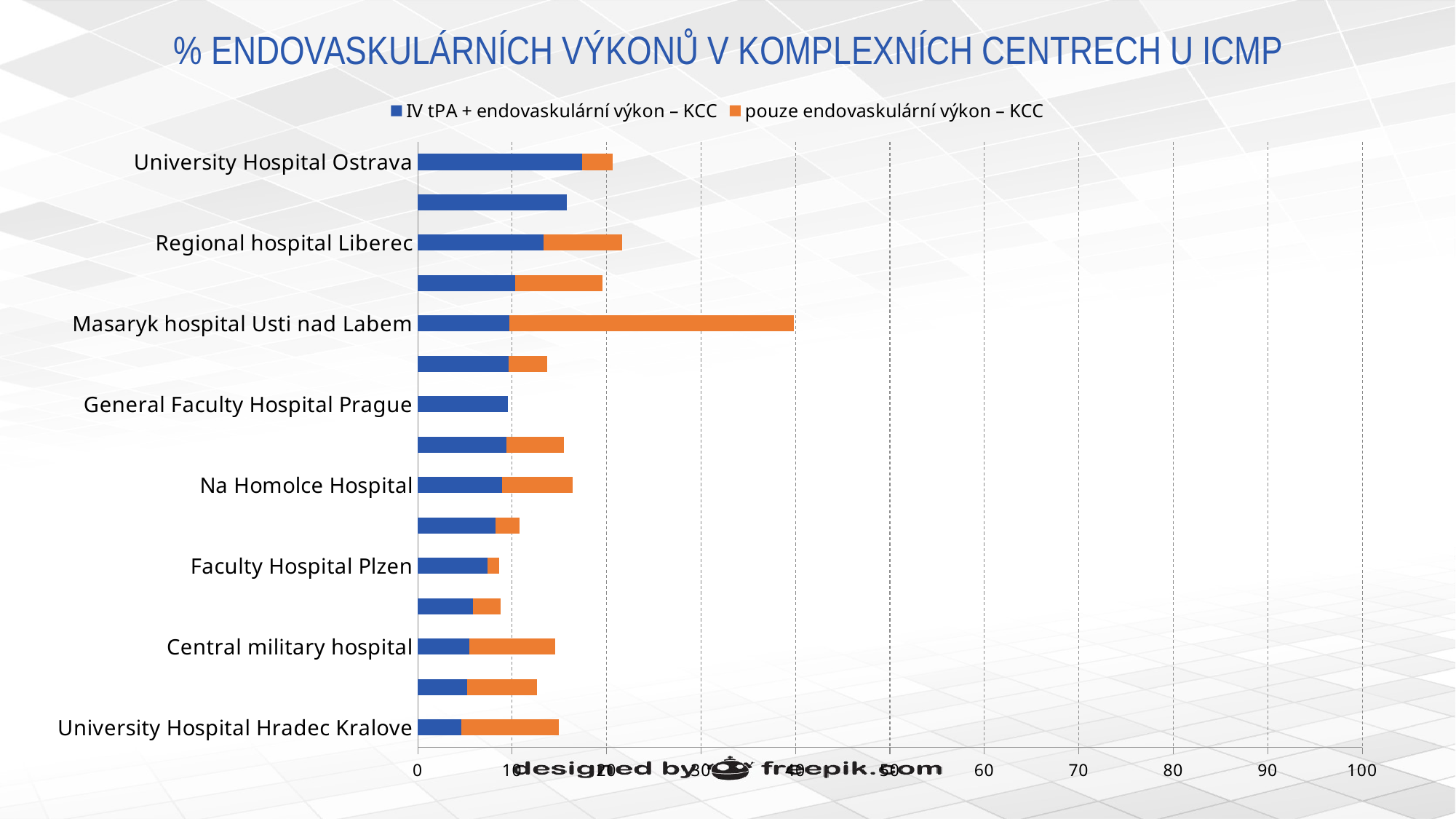
What are the two series named in the legend? IV tPA + endovaskulární výkon – KCC; pouze endovaskulární výkon – KCC What kind of chart is shown on the slide? bar chart Is the total bar for Masaryk hospital Usti nad Labem greater or less than 30? greater How many bars are plotted in the chart? 15 Is the total bar for Faculty Hospital Plzen greater or less than 10? less Which hospital has the longest total bar? Masaryk hospital Usti nad Labem Which hospital has the largest orange (pouze endovaskulární výkon – KCC) segment? Masaryk hospital Usti nad Labem How many series does the legend list? 2 Is the total bar for University Hospital Hradec Kralove greater or less than 10? greater Which has the longer total bar, University Hospital Ostrava or Masaryk hospital Usti nad Labem? Masaryk hospital Usti nad Labem